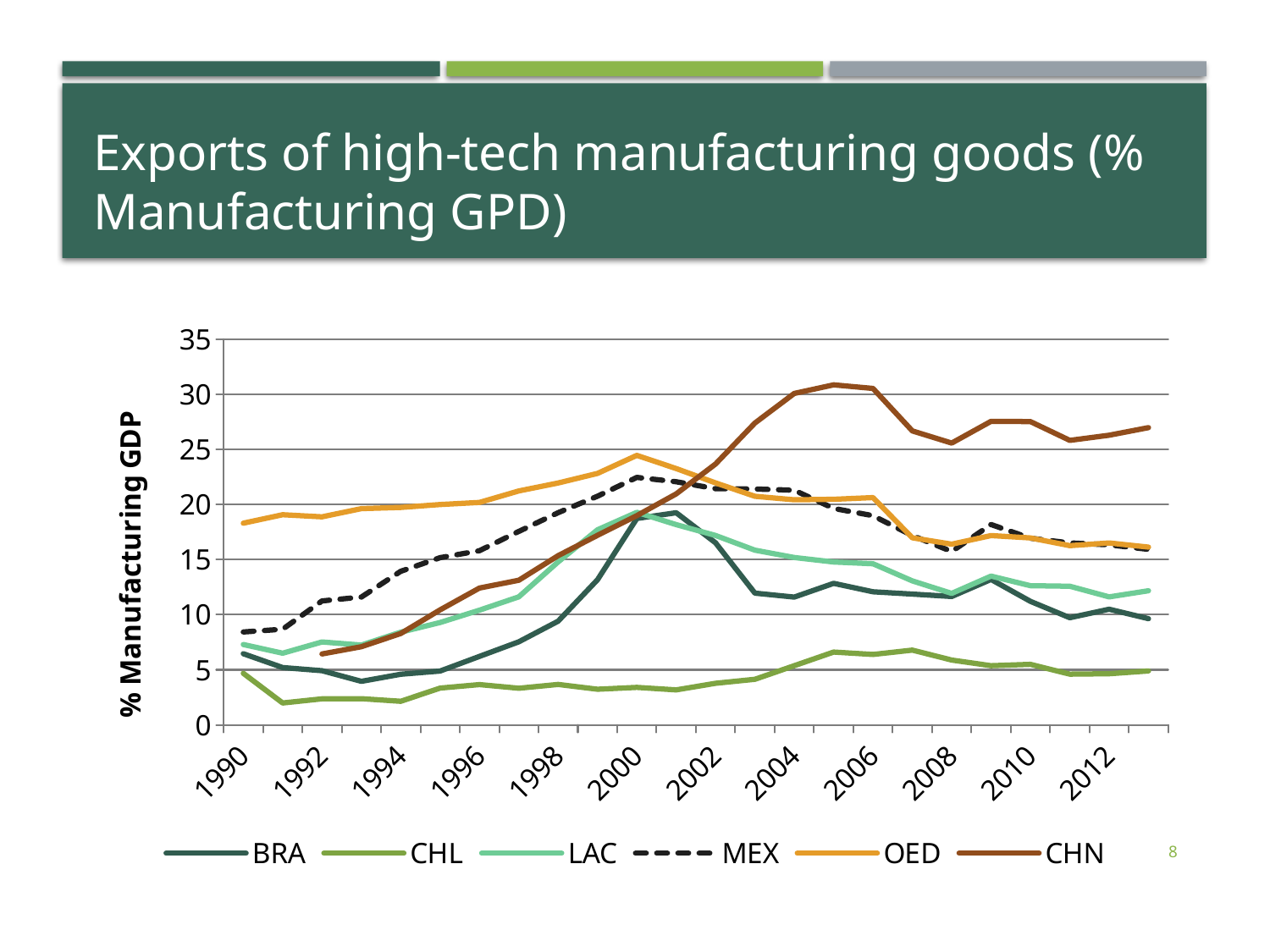
Is the value for CHL in 1992 greater or less than 5? less Is the value for MEX in 1990 greater or less than 10? less What is the label on the vertical axis of the chart? % Manufacturing GDP Is the value for CHN in 2004 greater or less than 25? greater In 2012, which is larger, the value for CHN or the value for BRA? CHN What kind of chart is shown on the slide? line chart Which series is drawn with a dashed line? MEX Does the CHN series rise or fall between 1992 and 2004? rise How many series does the legend list? 6 Which series has the lowest value in 2000? CHL Which series has the highest value in 2010? CHN